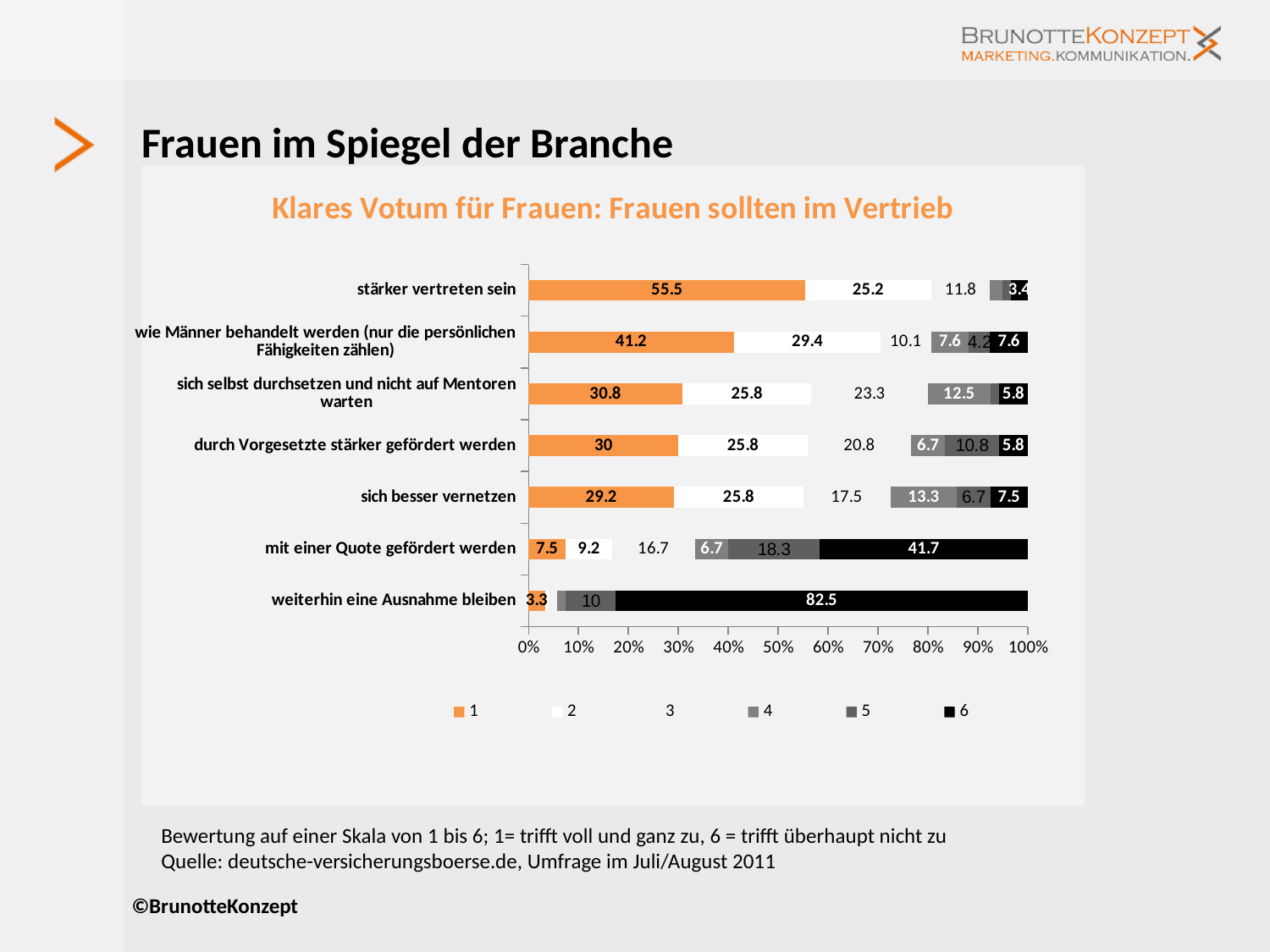
What is the value of series 5 for "mit einer Quote gefördert werden"? 18.3 What is the value of series 6 for "weiterhin eine Ausnahme bleiben"? 82.5 What is the value of series 2 for "wie Männer behandelt werden (nur die persönlichen Fähigkeiten zählen)"? 29.4 Which category has the highest value for series 1? stärker vertreten sein What kind of chart is shown on the slide? Stacked bar chart What is the value of series 1 for "stärker vertreten sein"? 55.5 What is the difference between the series 1 values for "wie Männer behandelt werden (nur die persönlichen Fähigkeiten zählen)" and "sich selbst durchsetzen und nicht auf Mentoren warten"? 10.4 Which category has the lowest value for series 1? weiterhin eine Ausnahme bleiben How many categories (statements) are plotted on the chart? 7 How many series does the legend list? 6 Which has the larger series 6 value: "mit einer Quote gefördert werden" or "weiterhin eine Ausnahme bleiben"? weiterhin eine Ausnahme bleiben What is the value of series 6 for "mit einer Quote gefördert werden"? 41.7